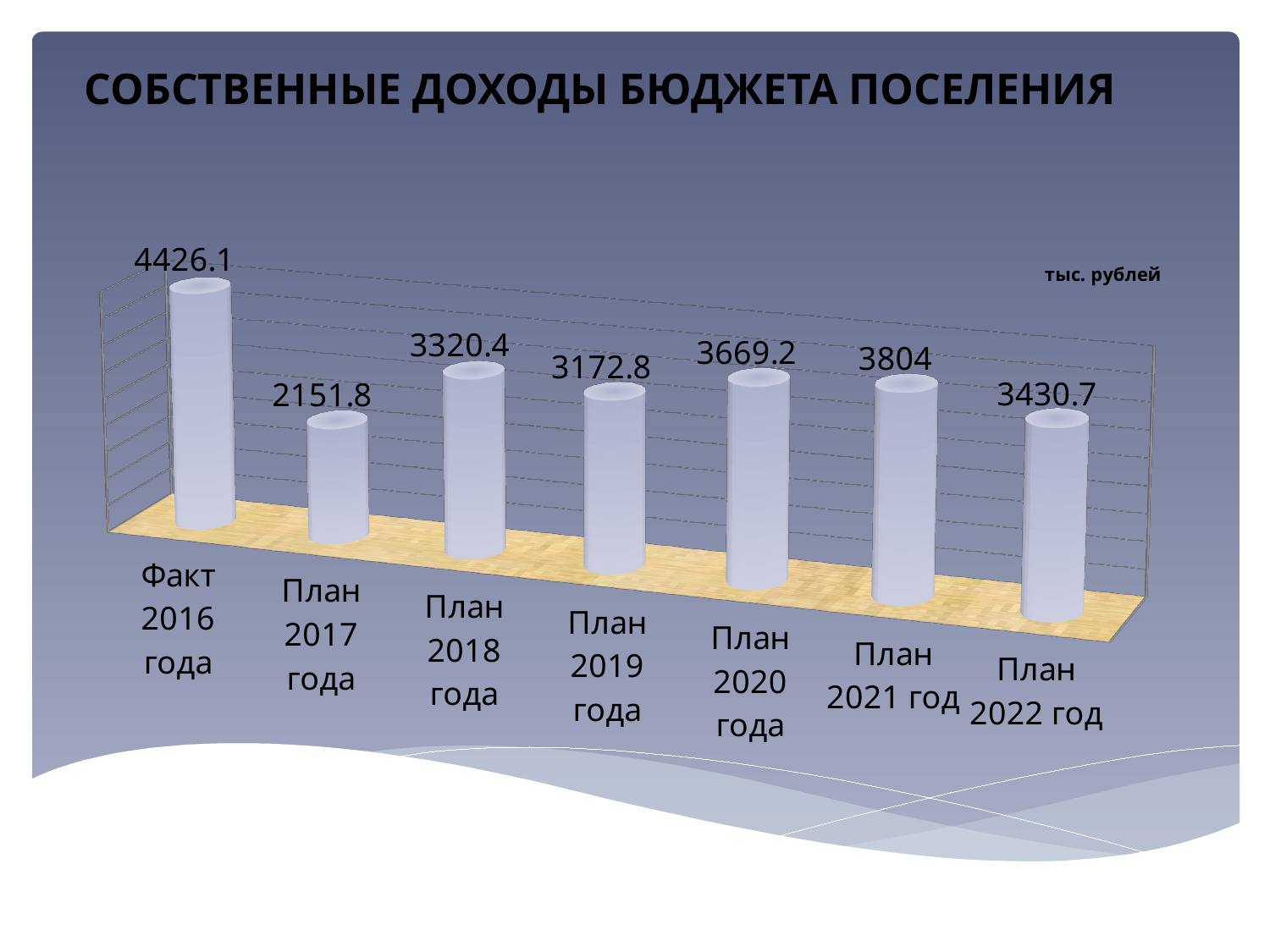
What is the value for План 2022 год? 3430.7 Which category has the lowest value? План 2017 года Which is larger, the value for План 2018 года or План 2019 года? План 2018 года What is the value for План 2017 года? 2151.8 What is the value for План 2020 года? 3669.2 What unit is indicated for the values in the chart? тыс. рублей What kind of chart is shown on the slide? Bar chart Which category has the highest value? Факт 2016 года How many categories are shown in the chart? 7 What is the difference between the values for План 2021 год and План 2022 год? 373.3 Do the values rise or fall from План 2017 года to План 2018 года? Rise What is the difference between the values for Факт 2016 года and План 2017 года? 2274.3